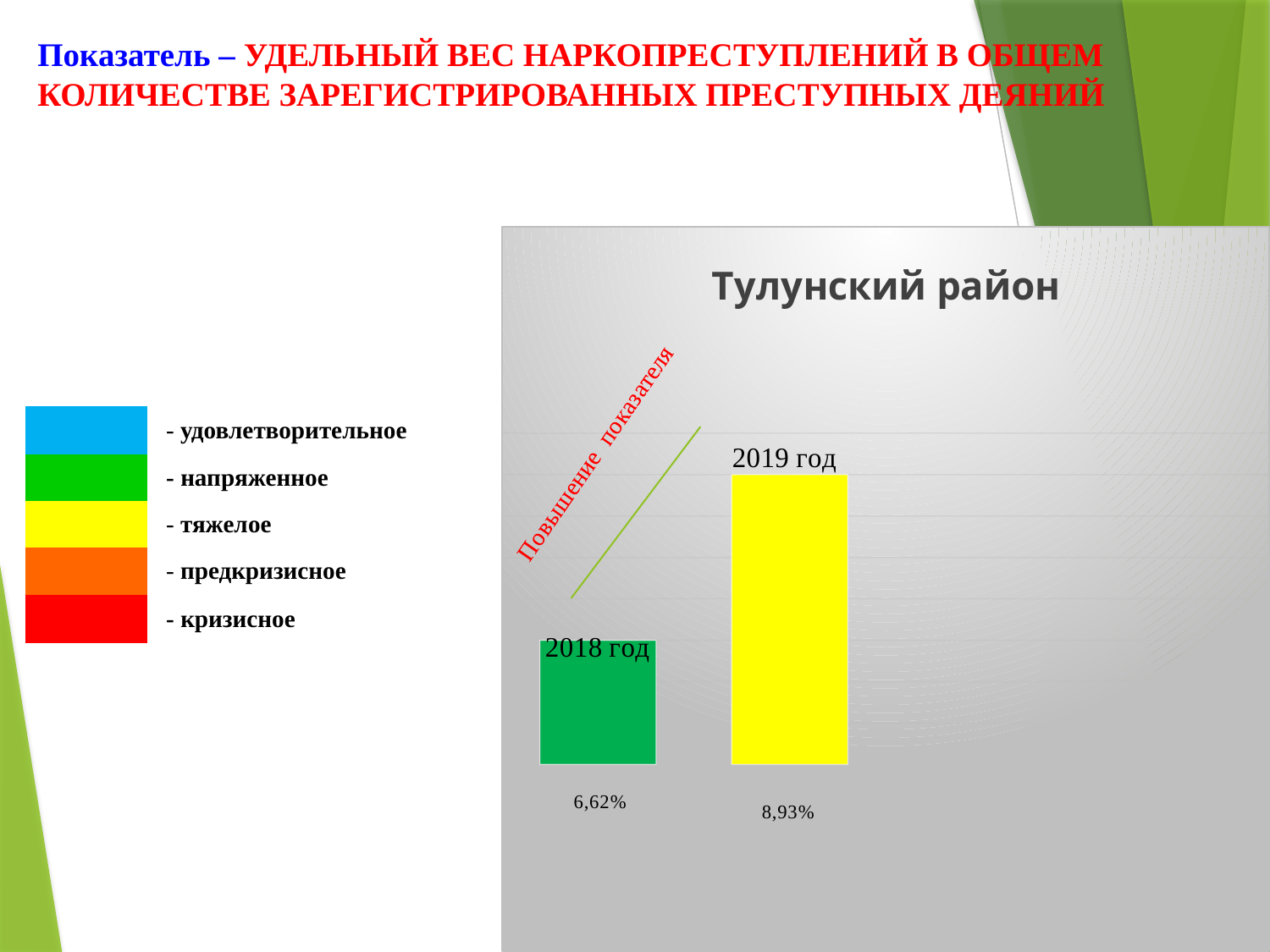
Which year has the higher value in the Тулунский район chart? 2019 год How many bars are shown in the Тулунский район chart? 2 Is the value for 2018 год larger or smaller than the value for 2019 год in the Тулунский район chart? smaller What is the value for 2018 год in the Тулунский район chart? 6,62% What is the title of the chart on the slide? Тулунский район What kind of chart is shown on the slide? bar chart By how much does the value for 2019 год exceed the value for 2018 год in the Тулунский район chart? 2,31% What is the value for 2019 год in the Тулунский район chart? 8,93% What colour is the bar for 2019 год in the Тулунский район chart? yellow Which year has the lower value in the Тулунский район chart? 2018 год Does the value rise or fall from 2018 год to 2019 год in the Тулунский район chart? rise